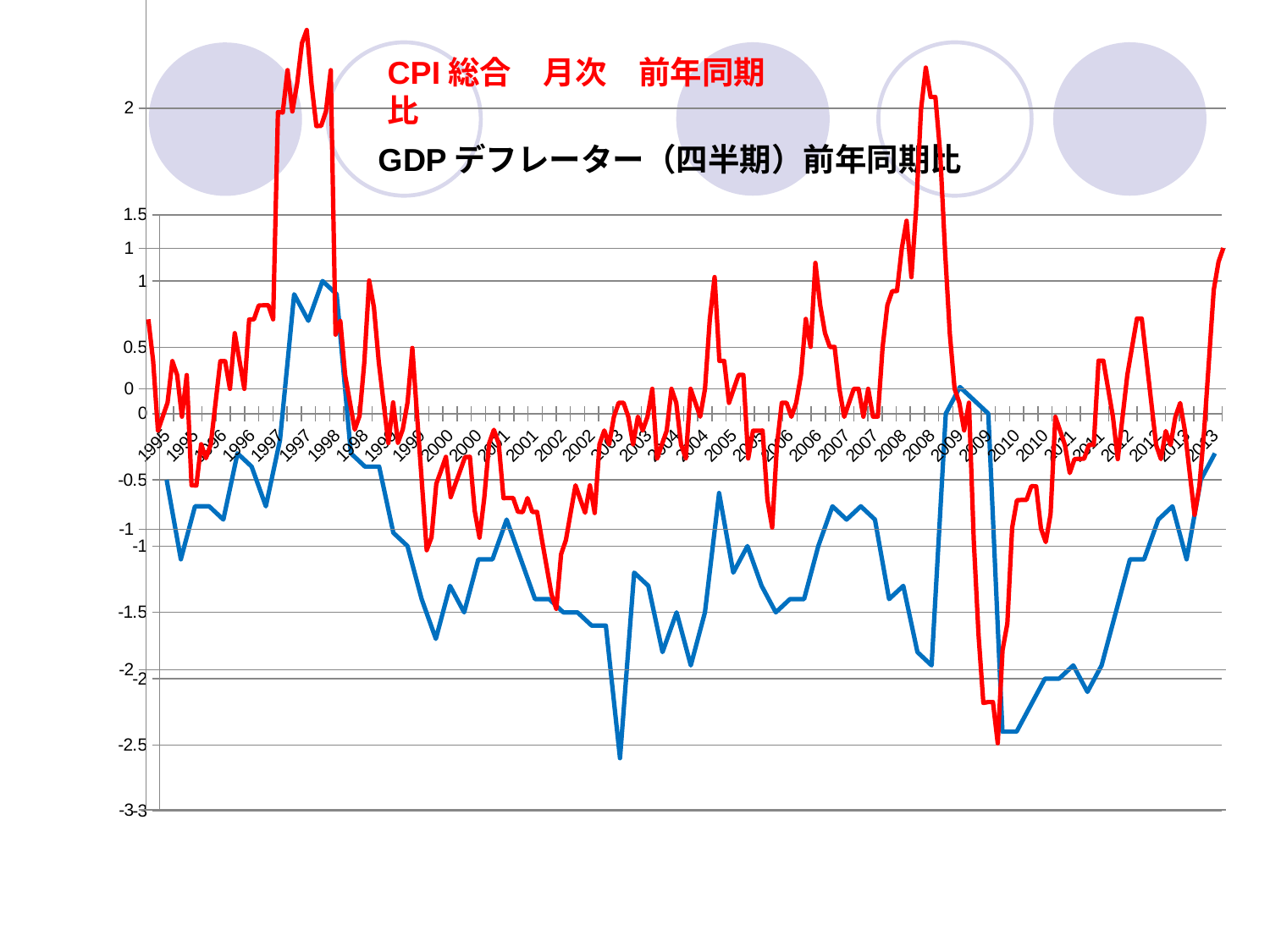
Is the peak value of the red CPI line around 1997 greater or less than 2? greater Does the red CPI line rise or fall over the course of 2013? rise Does the blue GDP deflator line generally rise or fall from 2010 to 2013? rise Is the value of the red CPI line at the end of 2013 greater or less than 0.5? greater Which colour is used for the GDP デフレーター（四半期）前年同期比 series? blue What kind of chart is shown on the slide? line chart Is the peak value of the red CPI line around 2008 greater or less than 2? greater Which colour is used for the CPI 総合 月次 前年同期比 series? red How many data series are plotted on the chart? 2 Which series reaches the higher maximum value, the red CPI line or the blue GDP deflator line? the red CPI line